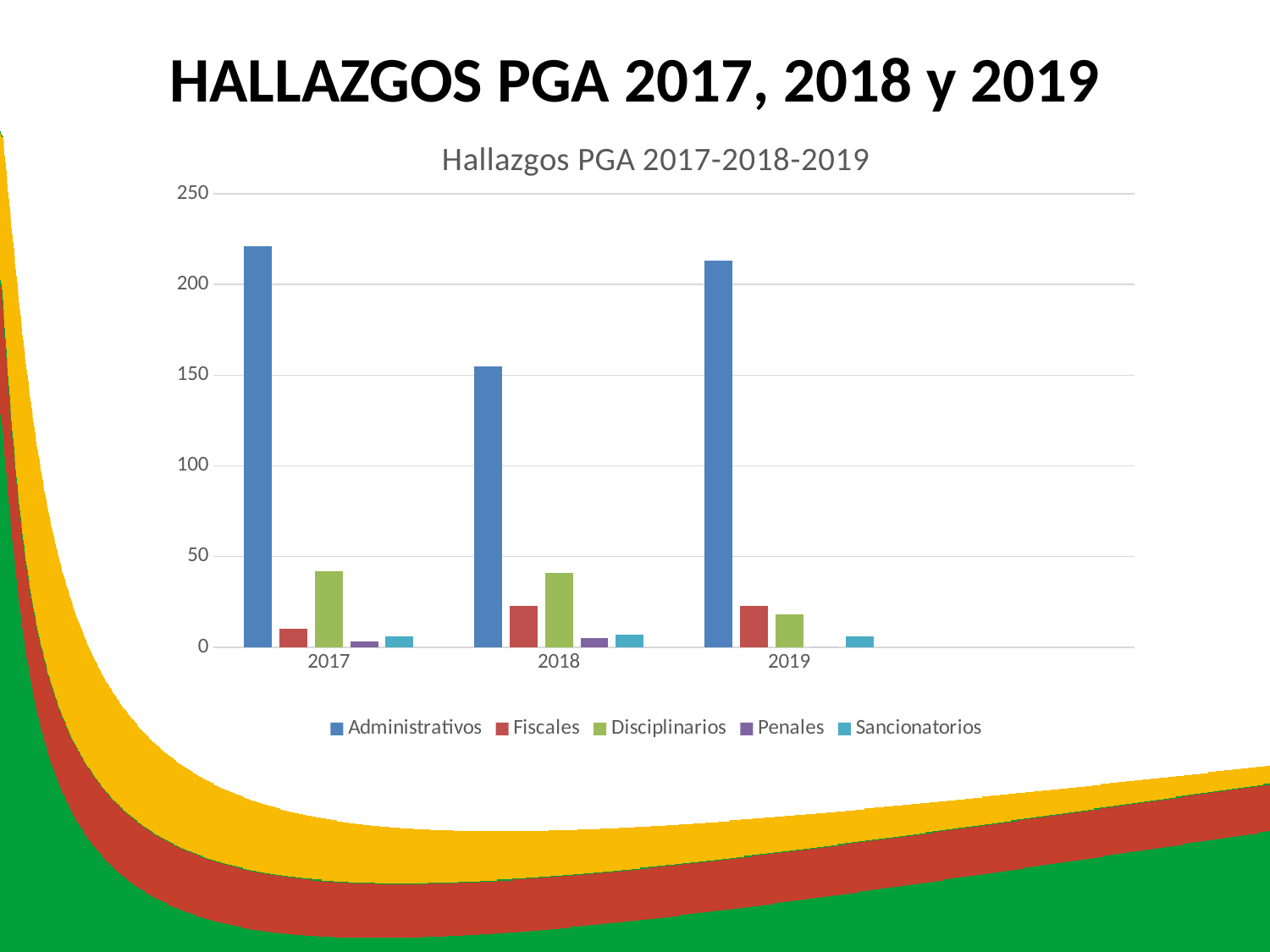
Which series has the lowest value in 2017? Penales Is the value for Administrativos in 2018 greater or less than 200? less In 2017, which is larger: Fiscales or Disciplinarios? Disciplinarios In 2019, which is larger: Fiscales or Disciplinarios? Fiscales Is the value for Administrativos in 2017 greater or less than 200? greater In which year is the Administrativos value lowest? 2018 Is the value for Disciplinarios in 2017 greater or less than 50? less What is the title shown inside the chart? Hallazgos PGA 2017-2018-2019 What kind of chart is shown on the slide? Bar chart How many years are shown on the x axis? 3 How many series does the legend list? 5